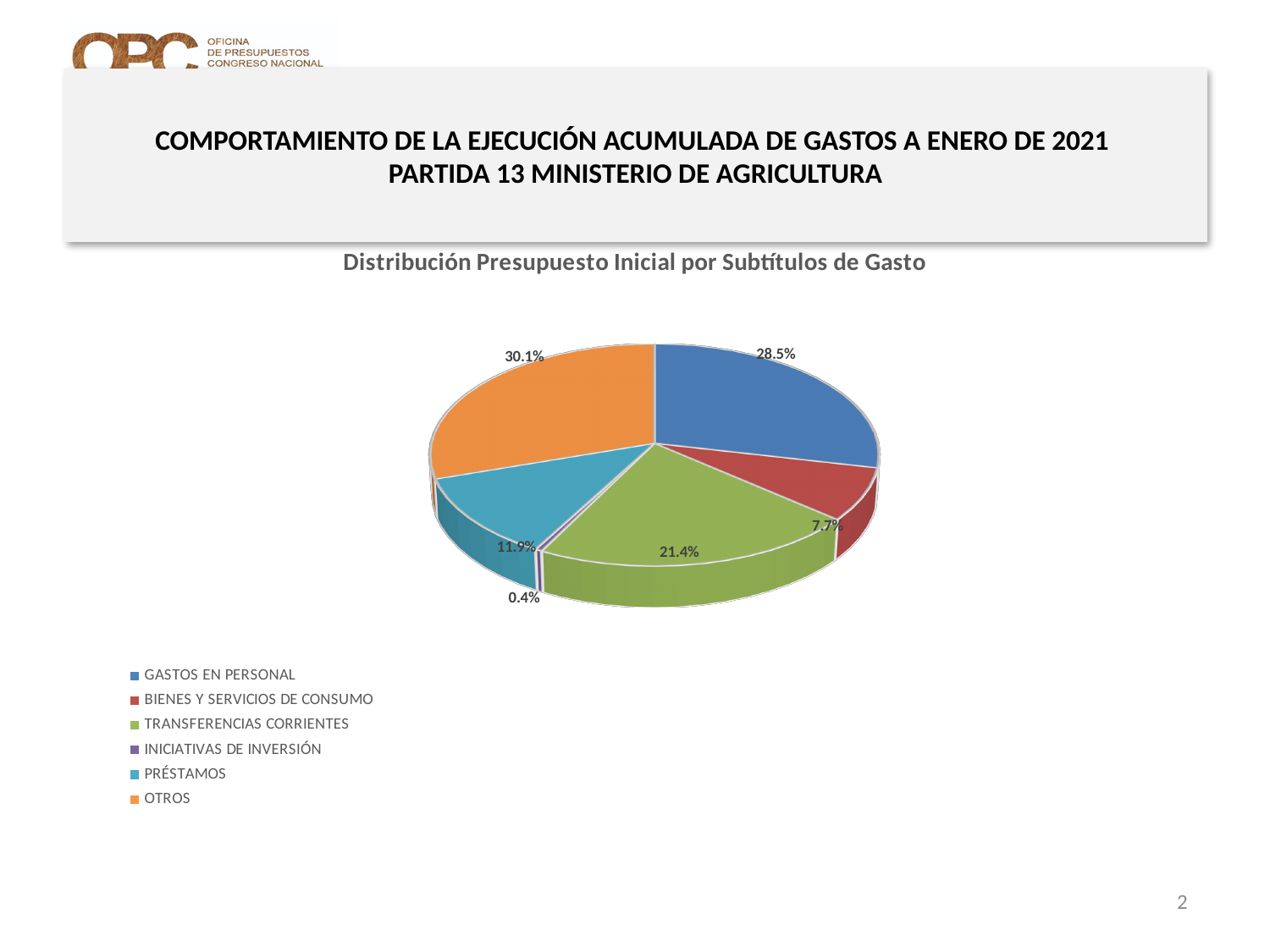
Which is larger, the share for TRANSFERENCIAS CORRIENTES or the share for PRÉSTAMOS? TRANSFERENCIAS CORRIENTES What share of the pie does OTROS represent? 30.1% What share of the pie does BIENES Y SERVICIOS DE CONSUMO represent? 7.7% What is the difference in percentage points between OTROS and GASTOS EN PERSONAL? 1.6 What is the title of the chart? Distribución Presupuesto Inicial por Subtítulos de Gasto What share of the pie does PRÉSTAMOS represent? 11.9% Which category has the smallest share of the pie? INICIATIVAS DE INVERSIÓN How many categories does the legend list? 6 What kind of chart is shown on the slide? Pie chart Which category has the largest share of the pie? OTROS